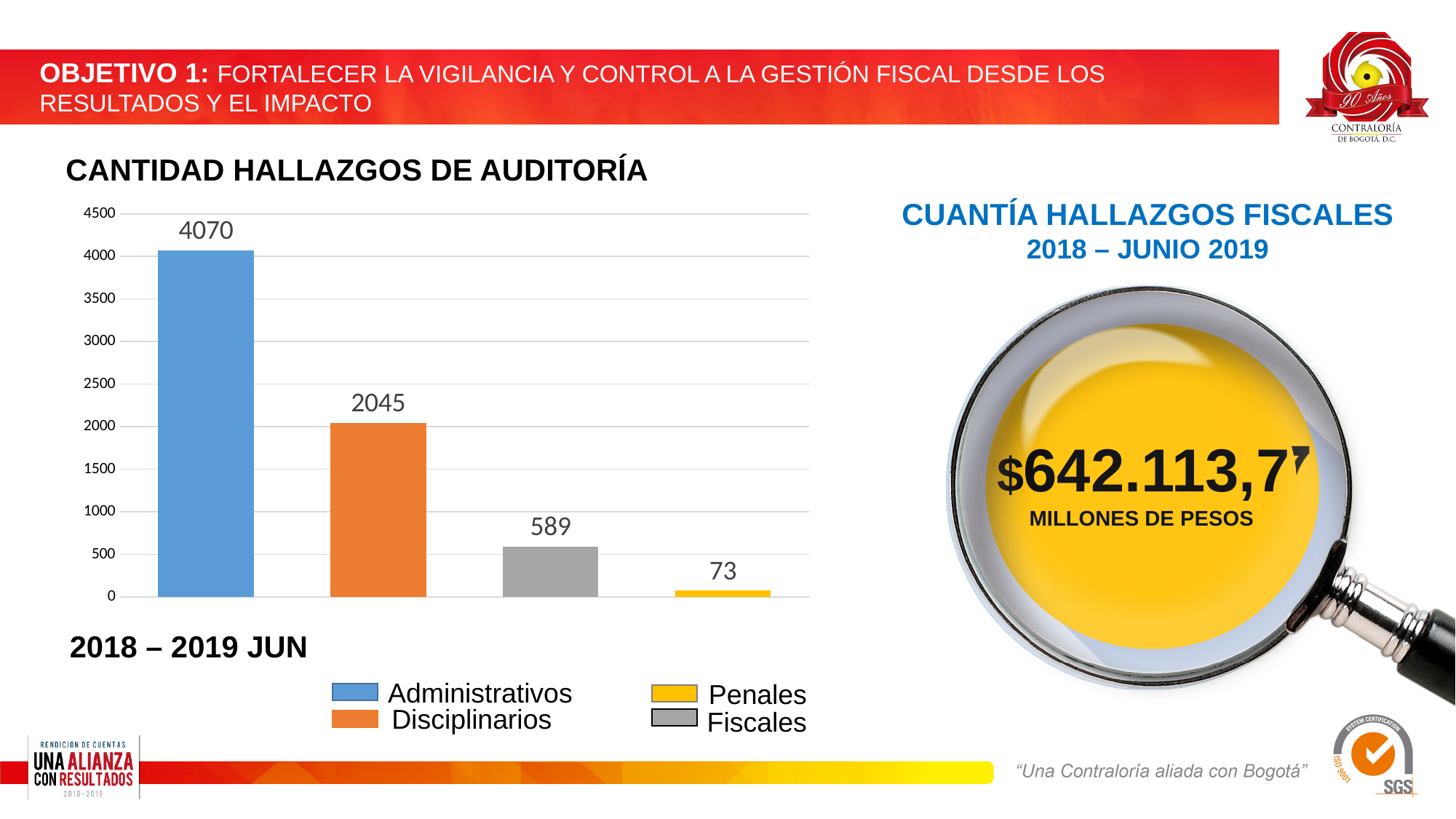
What type of chart is the CANTIDAD HALLAZGOS DE AUDITORÍA chart? bar chart Is the value for Disciplinarios in the CANTIDAD HALLAZGOS DE AUDITORÍA chart greater or less than 2500? less What is the value for Administrativos in the CANTIDAD HALLAZGOS DE AUDITORÍA chart? 4070 How many categories are shown in the CANTIDAD HALLAZGOS DE AUDITORÍA chart? 4 What is the value for Disciplinarios in the CANTIDAD HALLAZGOS DE AUDITORÍA chart? 2045 What is the value for Penales in the CANTIDAD HALLAZGOS DE AUDITORÍA chart? 73 What is the value for Fiscales in the CANTIDAD HALLAZGOS DE AUDITORÍA chart? 589 Which category has the highest value in the CANTIDAD HALLAZGOS DE AUDITORÍA chart? Administrativos What is the difference between Administrativos and Disciplinarios in the CANTIDAD HALLAZGOS DE AUDITORÍA chart? 2025 What colour is the Fiscales bar in the CANTIDAD HALLAZGOS DE AUDITORÍA chart? grey Which is larger in the CANTIDAD HALLAZGOS DE AUDITORÍA chart, Fiscales or Penales? Fiscales Which category has the lowest value in the CANTIDAD HALLAZGOS DE AUDITORÍA chart? Penales